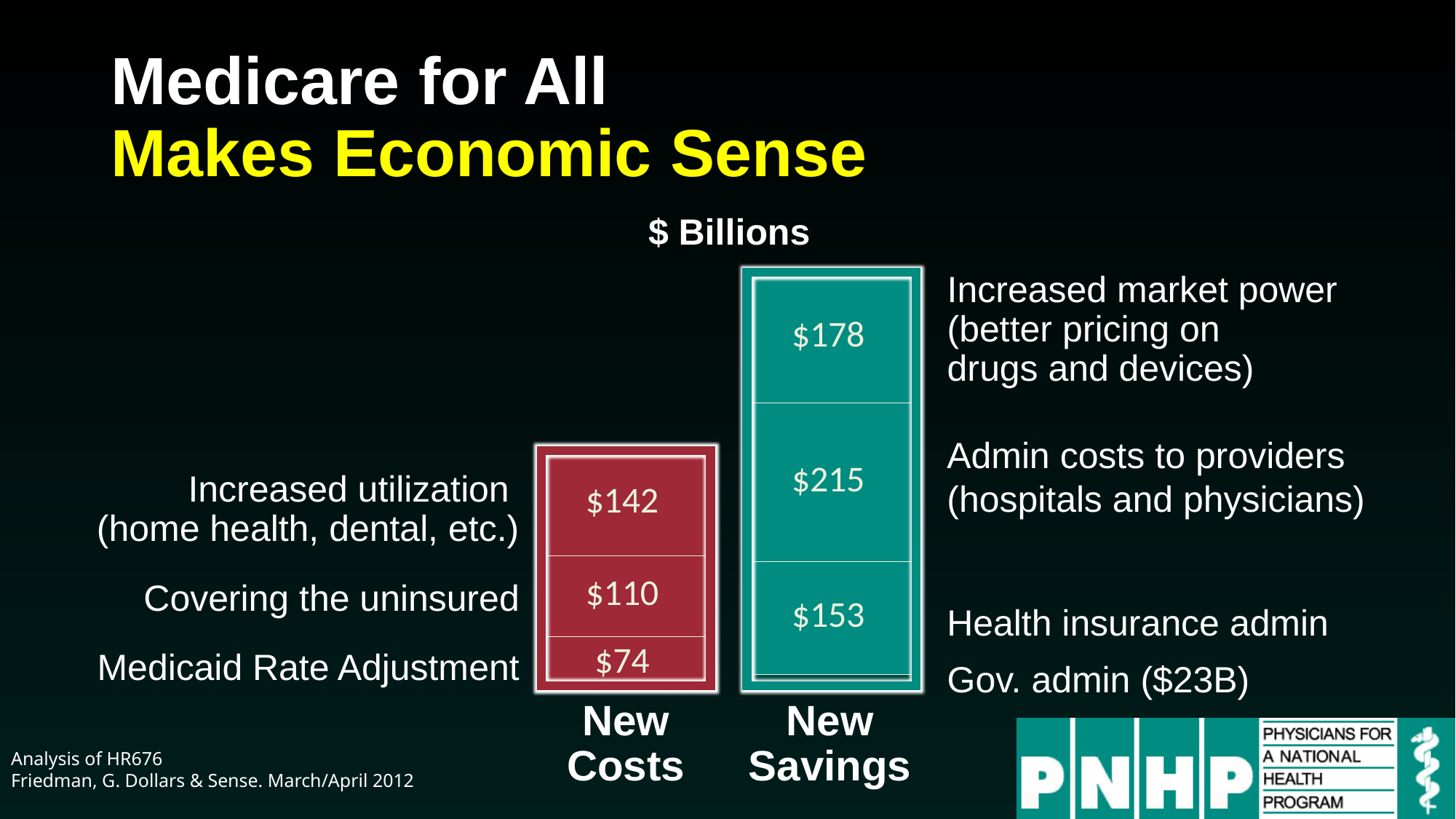
What is the total of the New Costs bar? $326 What is the value of the Medicaid Rate Adjustment segment in the New Costs bar? $74 What is the value of the Health insurance admin segment in the New Savings bar? $153 What is the value of the Increased utilization segment in the New Costs bar? $142 Which bar is taller, New Costs or New Savings? New Savings What is the value of the Covering the uninsured segment in the New Costs bar? $110 What is the total of the New Savings bar? $569 Which segment in the New Savings bar has the largest value? Admin costs to providers What unit is shown above the chart? $ Billions What is the difference between the Increased market power segment ($178) and the Increased utilization segment ($142)? $36 What is the value of the Admin costs to providers segment in the New Savings bar? $215 Which segment in the New Costs bar has the smallest value? Medicaid Rate Adjustment